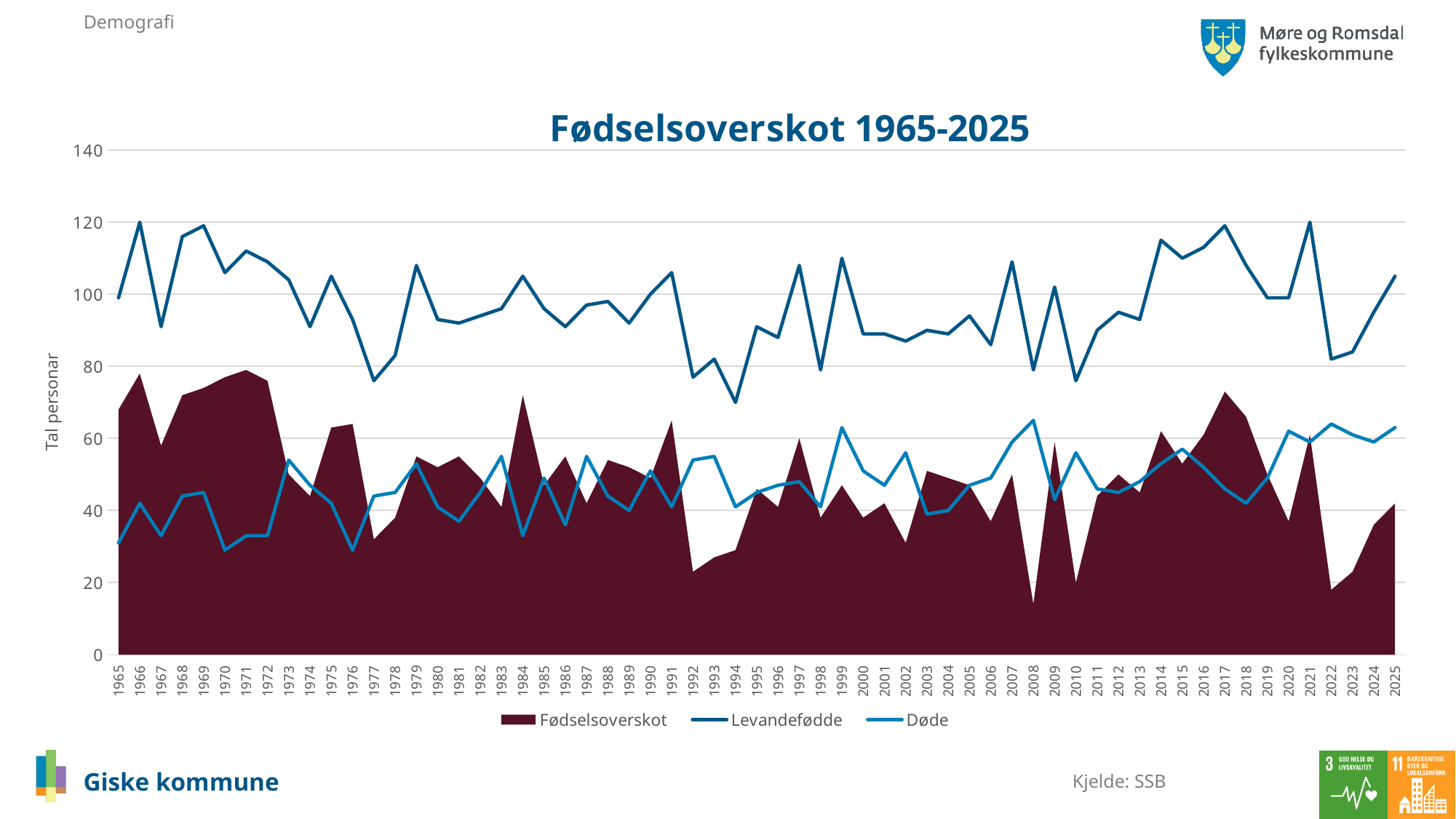
Is the Levandefødde value for 1994 greater or less than 80? less What is the title of the chart? Fødselsoverskot 1965-2025 Is the Døde value for 2008 greater or less than 60? greater In 1965, which is larger: Levandefødde or Døde? Levandefødde Which series is drawn as a filled dark red area? Fødselsoverskot In which year is the Levandefødde series at its lowest? 1994 Is the Fødselsoverskot value for 2008 greater or less than 20? less How many series does the chart legend list? 3 How many years are plotted along the x axis of the chart? 61 What is the label on the vertical axis of the chart? Tal personar